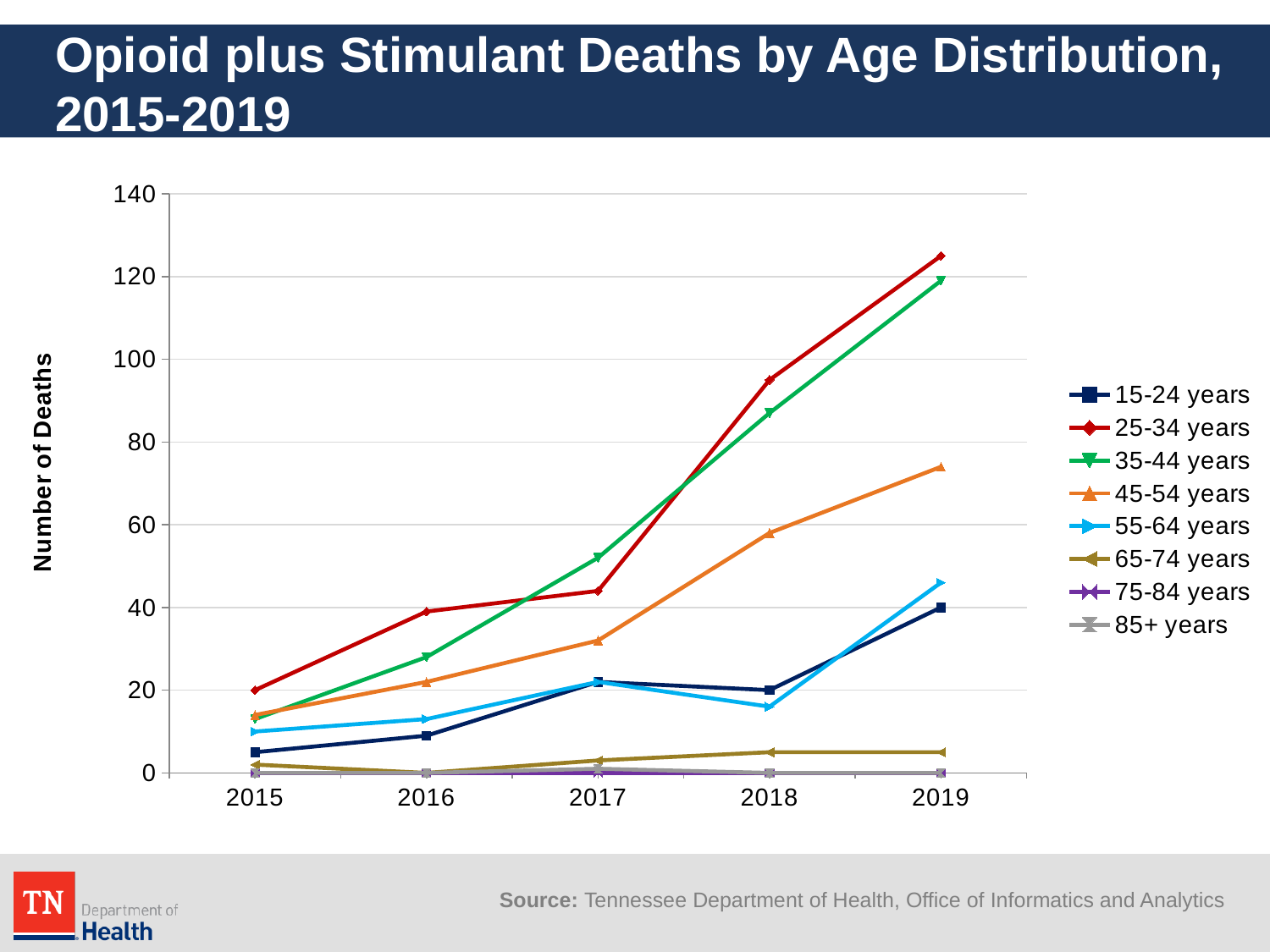
Is the value for 45-54 years in 2019 greater or less than 80? less How many series does the legend list? 8 Which age group has the highest number of deaths in 2017? 35-44 years Which age group has the highest number of deaths in 2019? 25-34 years Does the number of deaths for 25-34 years rise or fall from 2015 to 2019? rise Is the value for 35-44 years in 2018 greater or less than 80? greater Is the value for 25-34 years in 2019 greater or less than 120? greater How many years are plotted along the x axis? 5 What kind of chart is shown on the slide? line chart In 2019, which is larger: the value for 45-54 years or the value for 55-64 years? 45-54 years Which age group has the highest number of deaths in 2016? 25-34 years